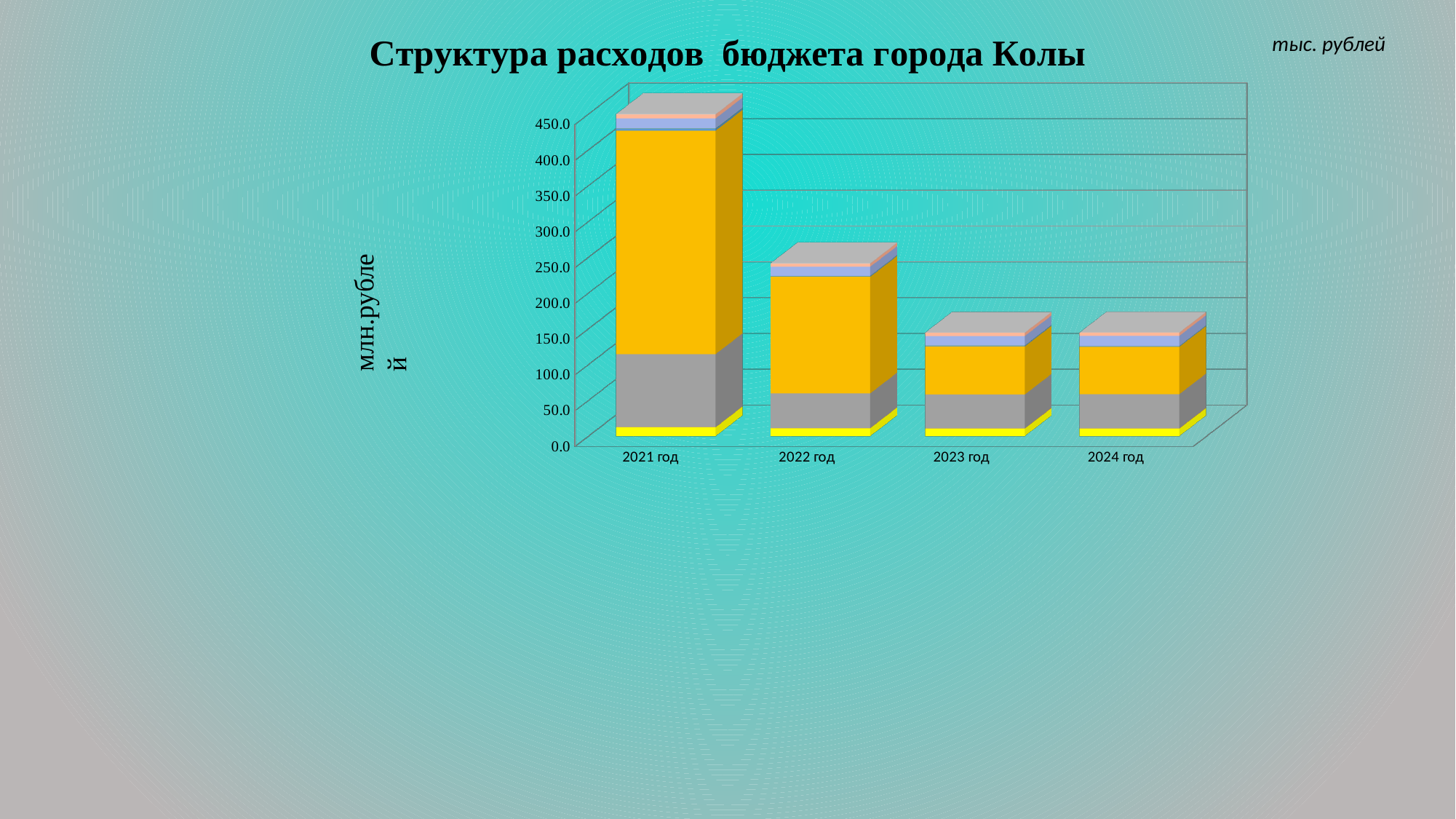
What is the label on the vertical axis of the chart? млн.рублей Which year has the highest total bar in the chart? 2021 год What kind of chart is shown on the slide? Stacked bar chart How many categories (years) are shown on the x axis of the chart? 4 Is the total value for 2021 год greater or less than 400.0? greater What is the title of the chart? Структура расходов бюджета города Колы Is the total value for 2023 год greater or less than 200.0? less Which is larger, the total for 2021 год or the total for 2022 год? 2021 год Which is larger, the total for 2022 год or the total for 2023 год? 2022 год Is the total value for 2022 год greater or less than 200.0? greater Do the total bar values rise or fall from 2021 год to 2024 год? fall